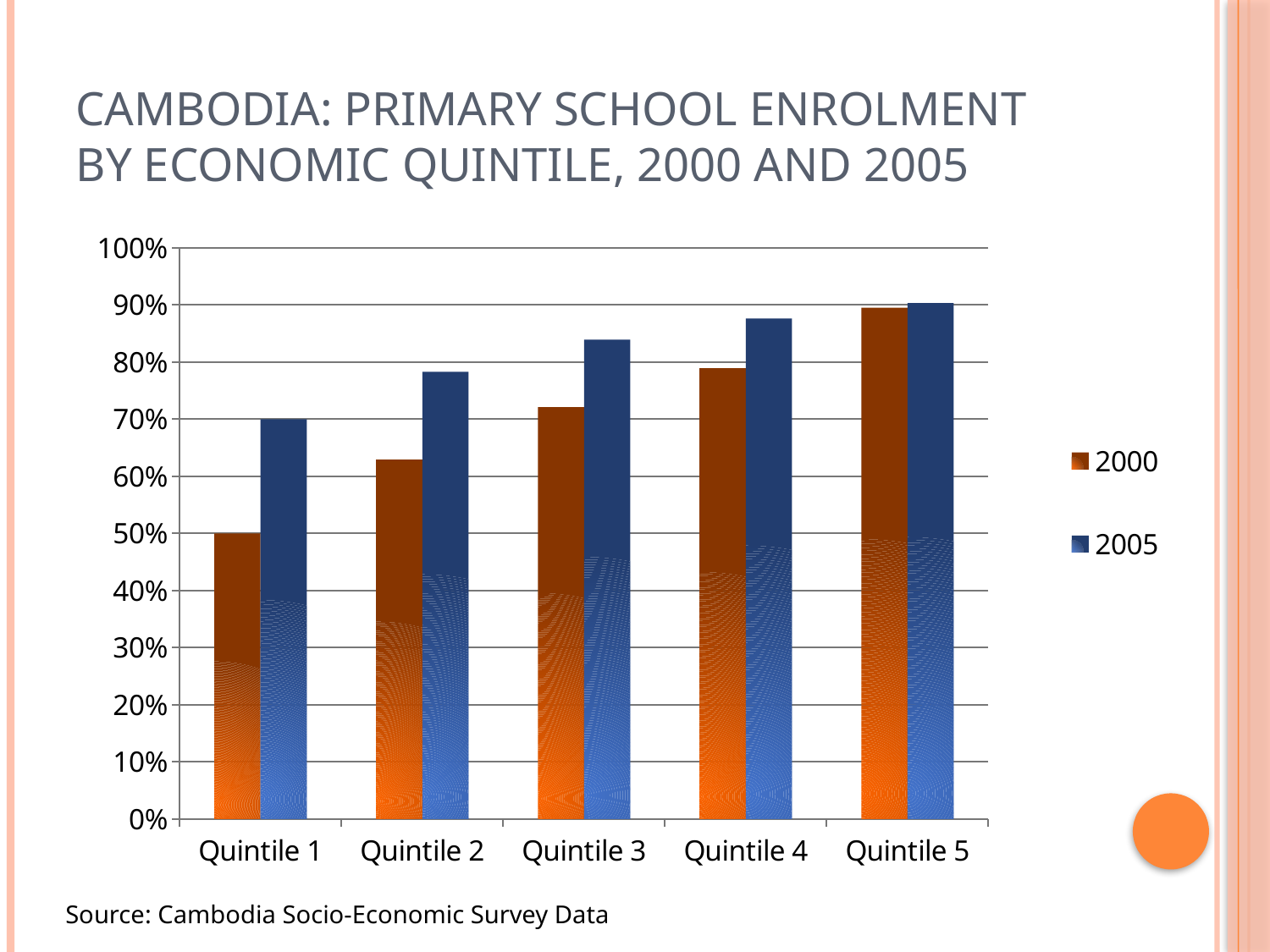
How many quintile categories are shown on the x axis? 5 Do the 2005 enrolment values rise or fall from Quintile 1 to Quintile 5? rise Which quintile has the highest enrolment for 2005? Quintile 5 Is the 2005 value for Quintile 2 greater or less than 70%? greater Is the 2000 value for Quintile 2 greater or less than 60%? greater What kind of chart is shown on the slide? Bar chart Which colour represents the 2005 series in the legend? Blue Is the 2005 value for Quintile 3 greater or less than 80%? greater Which quintile has the lowest enrolment for 2000? Quintile 1 How many series does the legend list? 2 For Quintile 1, which is larger: the 2000 value or the 2005 value? 2005